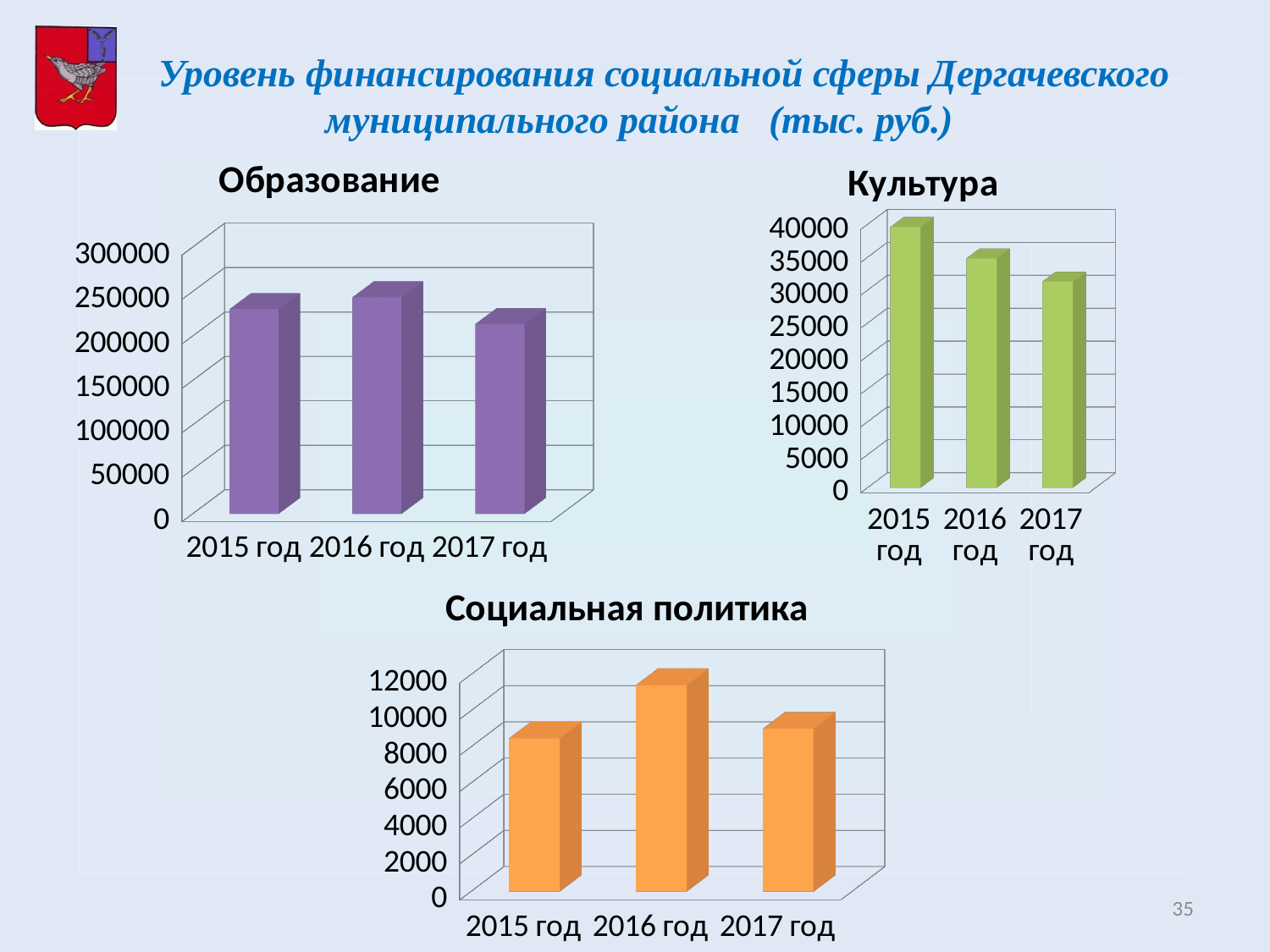
In the 'Культура' chart, which year has the highest value? 2015 год In the 'Социальная политика' chart, which is larger, the value for 2015 год or 2016 год? 2016 год In the 'Культура' chart, is the value for 2017 год greater or less than 35000? less In the 'Культура' chart, do the values rise or fall from 2015 год to 2017 год? fall How many years are shown in the 'Культура' chart? 3 What type of chart is the 'Образование' chart? bar chart In the 'Образование' chart, which year has the lowest value? 2017 год In the 'Образование' chart, which year has the highest value? 2016 год In the 'Образование' chart, is the value for 2016 год greater or less than 200000? greater In the 'Социальная политика' chart, which year has the highest value? 2016 год In the 'Социальная политика' chart, which year has the lowest value? 2015 год In the 'Социальная политика' chart, is the value for 2016 год greater or less than 10000? greater